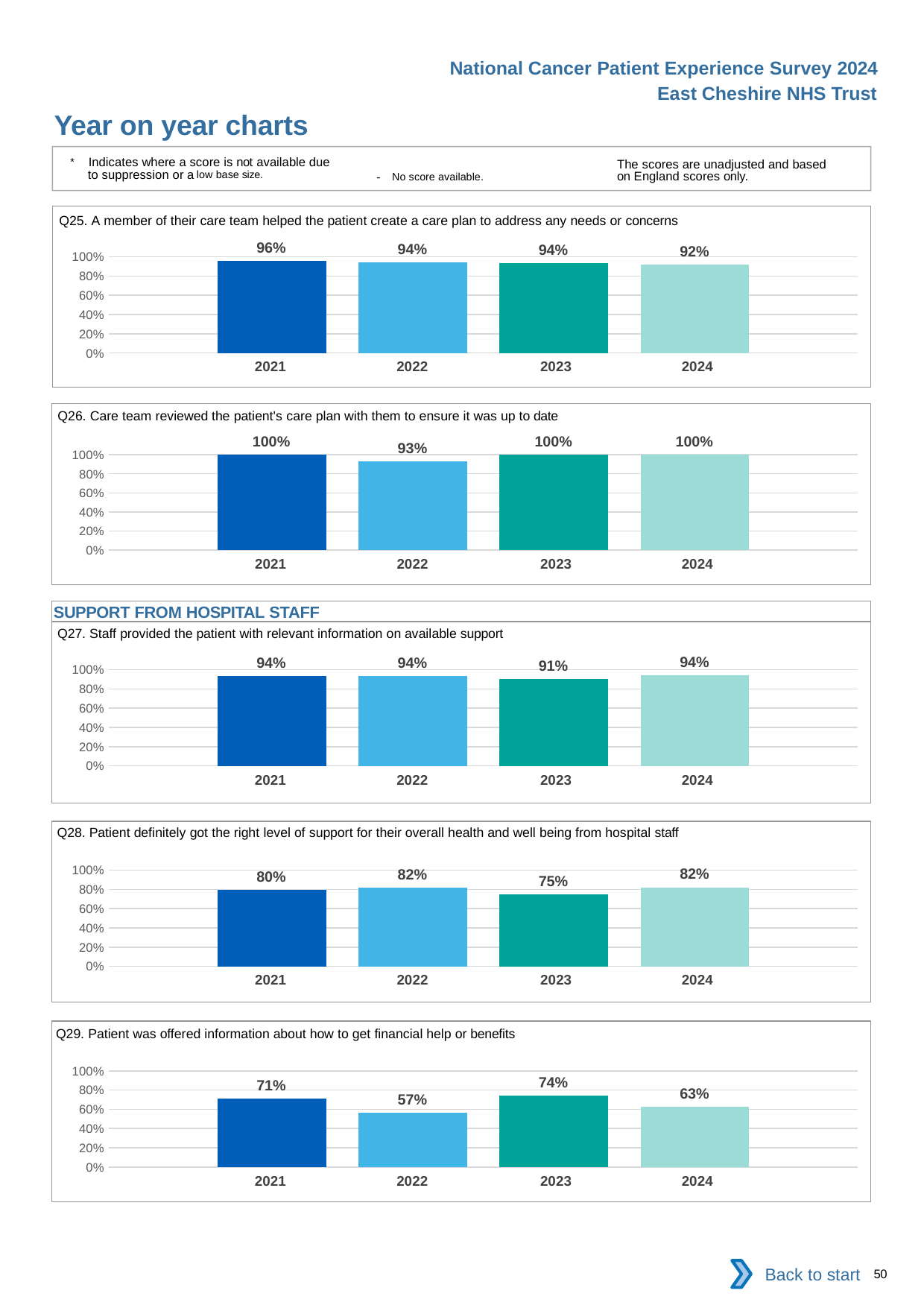
In the Q26 chart, which year has the lowest value? 2022 In the Q25 chart, what is the value for 2021? 96% In the Q29 chart, is the value for 2021 larger than the value for 2024? Yes In the Q25 chart, which year has the lowest value? 2024 In the Q29 chart, which year has the highest value? 2023 In the Q27 chart, what is the difference between the 2022 and 2023 values? 3% In the Q28 chart, what is the difference between the 2022 and 2023 values? 7% How many years are shown in the Q29 chart? 4 In the Q26 chart, what is the value for 2022? 93% In the Q27 chart, what is the value for 2023? 91% In the Q28 chart, which year has the lowest value? 2023 What type of chart is the Q28 chart? Bar chart